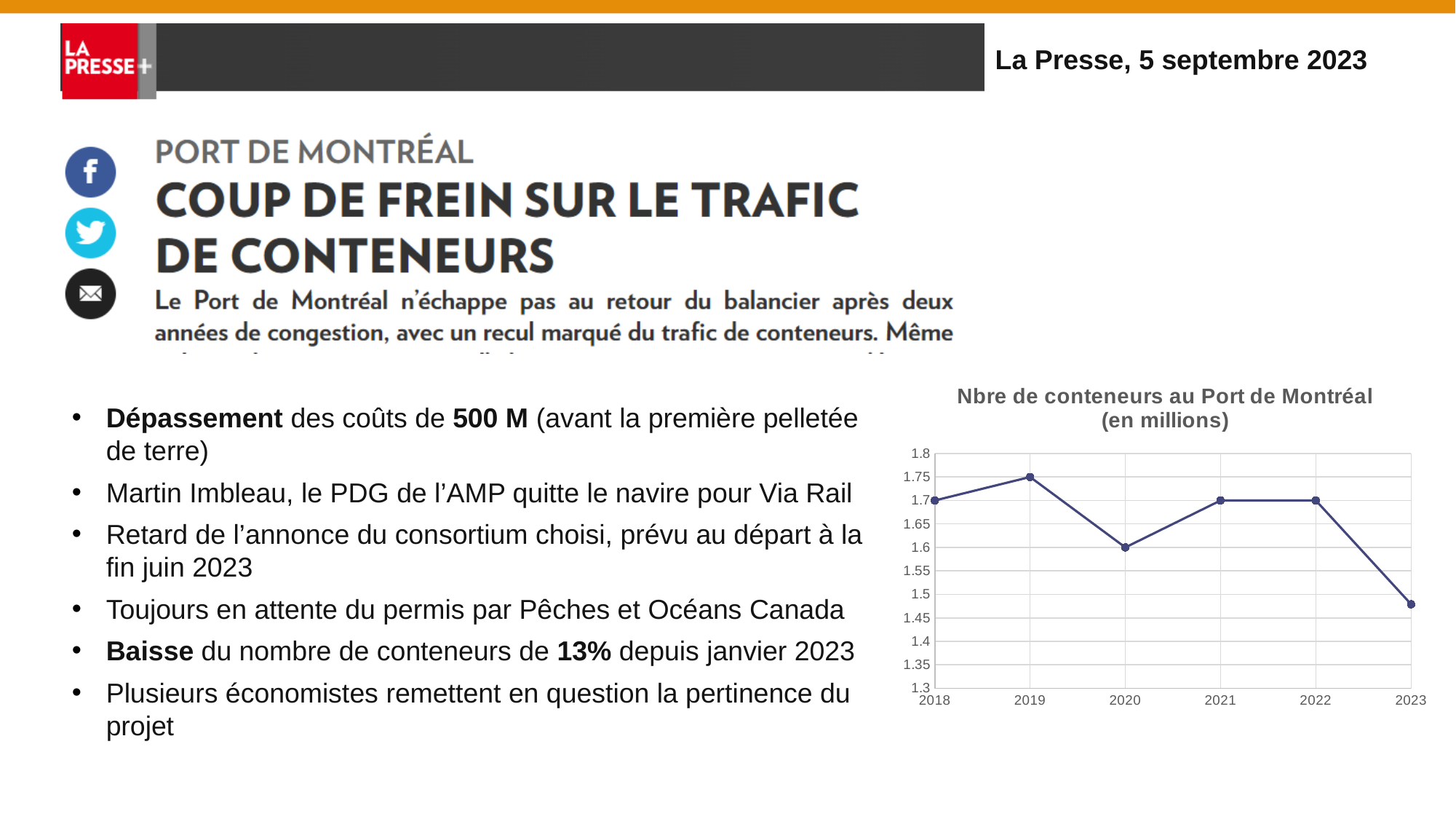
Does the value rise or fall from 2022 to 2023? fall How many years are plotted on the chart? 6 Is the value for 2023 greater or less than 1.5? less What is the difference between the values for 2019 and 2020? 0.15 What is the title of the chart? Nbre de conteneurs au Port de Montréal (en millions) Which year has the lowest value? 2023 Which year has the larger value, 2020 or 2021? 2021 Which year has the highest value? 2019 What kind of chart is shown on the slide? line chart What is the value for 2019? 1.75 What is the value for 2018? 1.7 What is the value for 2020? 1.6